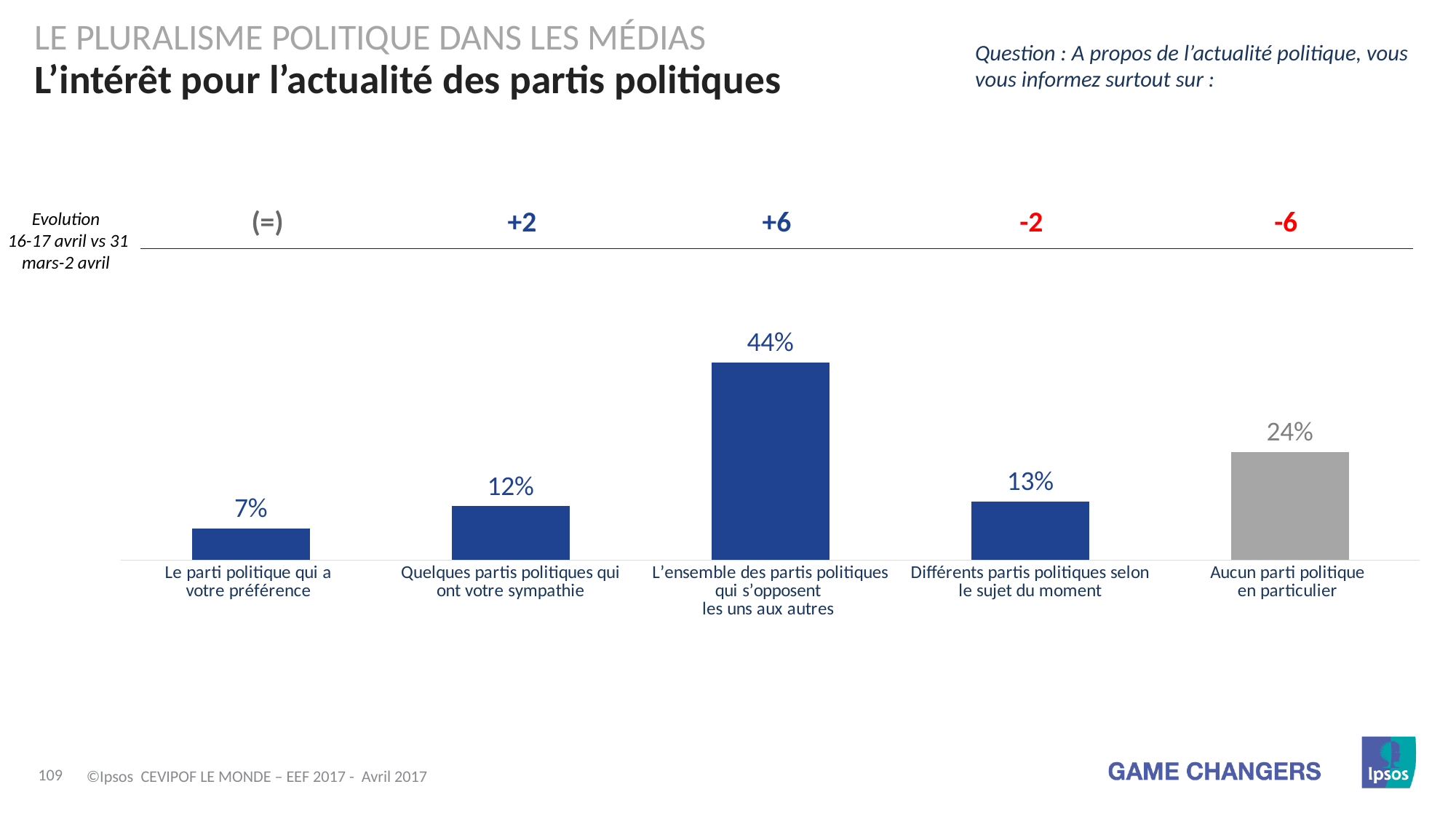
Which is larger: the value for "Quelques partis politiques qui ont votre sympathie" or for "Différents partis politiques selon le sujet du moment"? Différents partis politiques selon le sujet du moment What kind of chart is shown on the slide? Bar chart Which category has the lowest value? Le parti politique qui a votre préférence What is the value for "Aucun parti politique en particulier"? 24% What is the value for "Différents partis politiques selon le sujet du moment"? 13% Which category has the highest value? L'ensemble des partis politiques qui s'opposent les uns aux autres What is the evolution shown above the bar for "Aucun parti politique en particulier"? -6 What is the value for "Le parti politique qui a votre préférence"? 7% How many categories are shown in the chart? 5 What is the difference between the values for "L'ensemble des partis politiques qui s'opposent les uns aux autres" and "Aucun parti politique en particulier"? 20% What is the value for "L'ensemble des partis politiques qui s'opposent les uns aux autres"? 44% Which bar is coloured grey rather than blue? Aucun parti politique en particulier